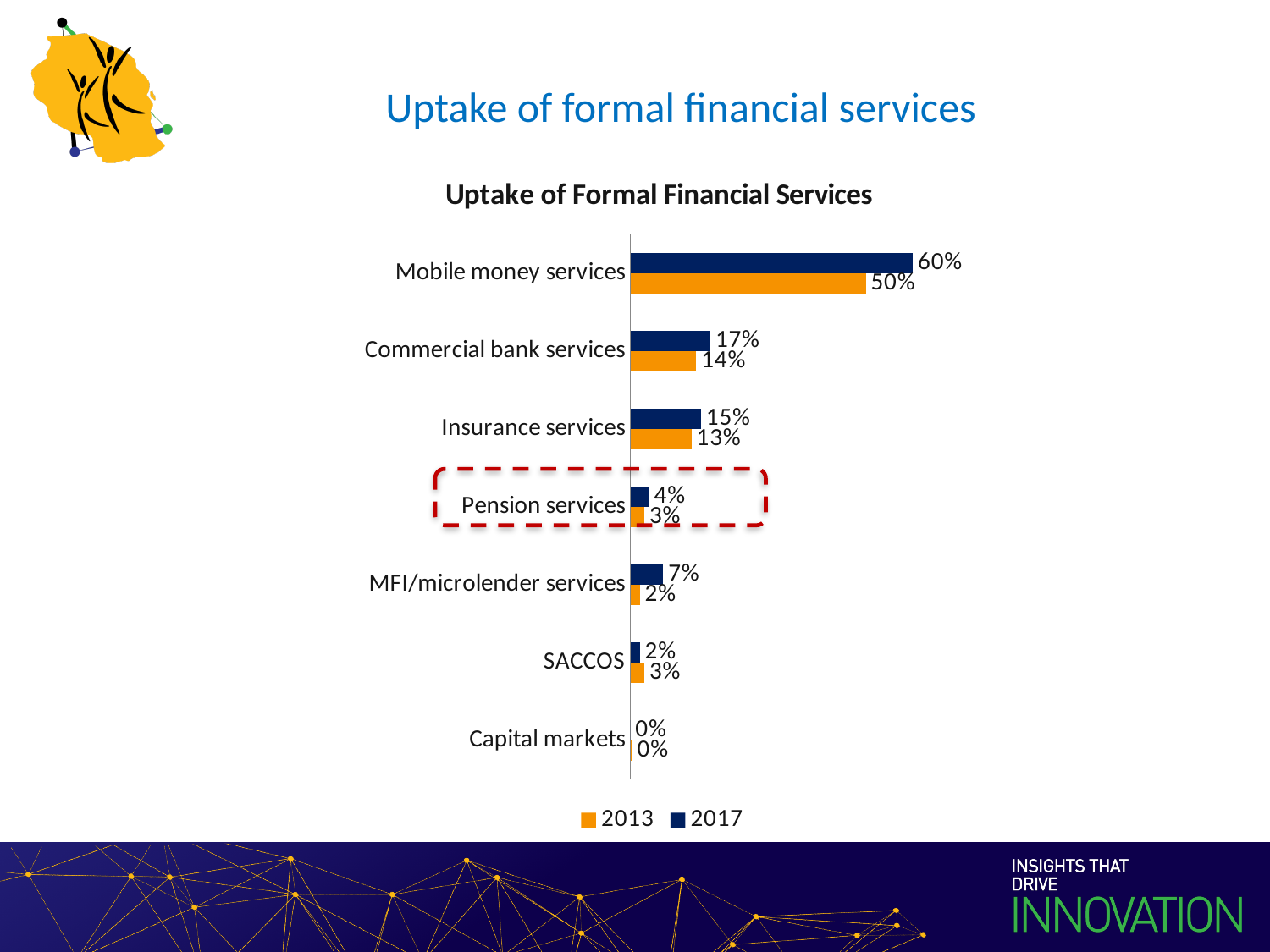
What is the 2013 value for Commercial bank services? 14% Which category is highlighted with a red dashed outline? Pension services How many categories are shown on the chart? 7 How many series does the legend list? 2 What is the 2017 value for Mobile money services? 60% Which is larger for SACCOS, the 2013 value or the 2017 value? 2013 Which category has the lowest 2013 value? Capital markets What is the 2013 value for MFI/microlender services? 2% Which category has the highest 2017 value? Mobile money services What is the 2017 value for Pension services? 4% What is the difference between the 2017 and 2013 values for Mobile money services? 10% What kind of chart is shown? Bar chart